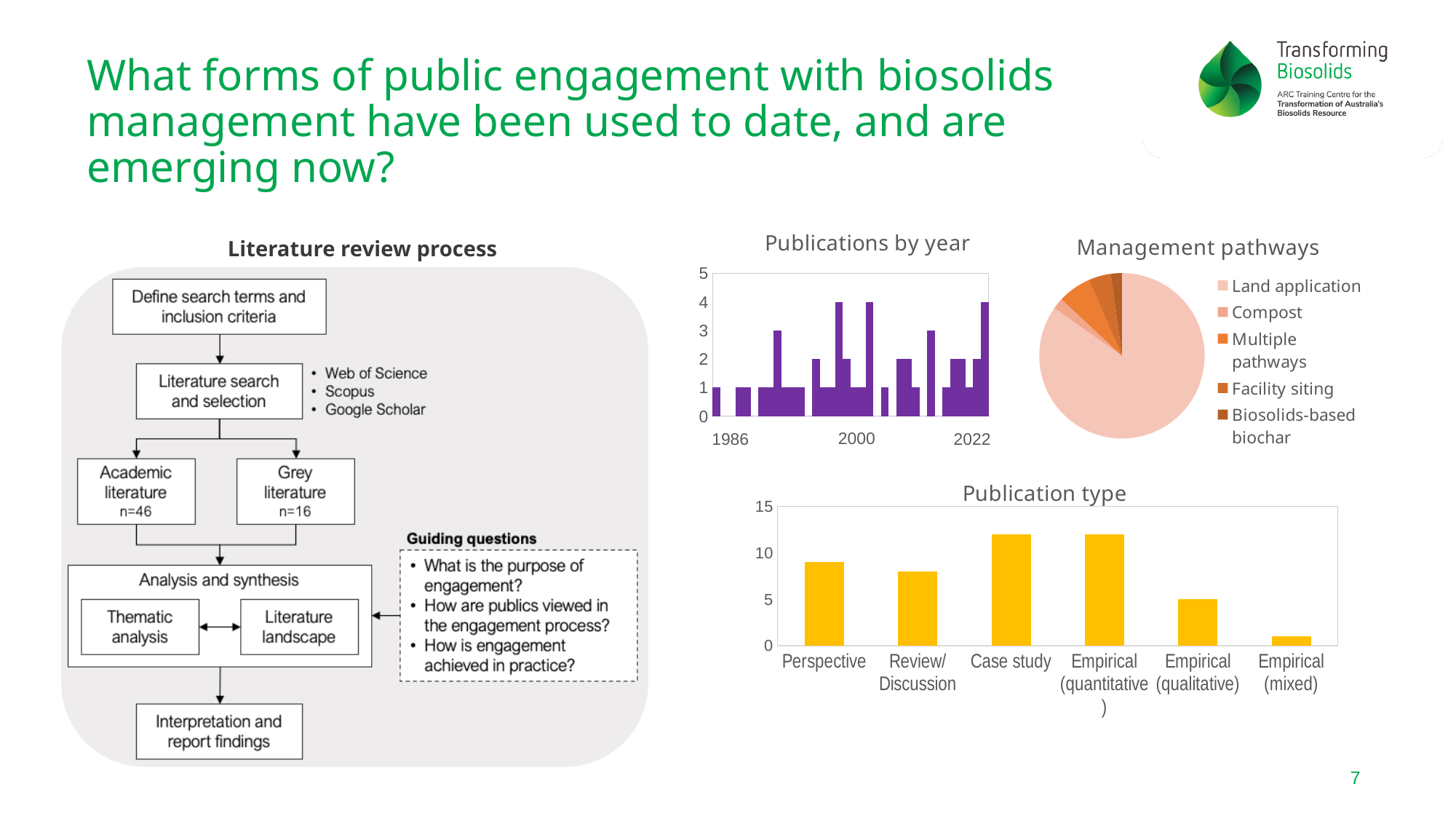
What kind of chart is the 'Management pathways' chart? pie chart What is the last year label shown on the x axis of the 'Publications by year' chart? 2022 How many entries does the legend of the 'Management pathways' chart list? 5 In the 'Publication type' chart, which is larger: Perspective or Empirical (qualitative)? Perspective What kind of chart is the 'Publication type' chart? bar chart In the 'Publication type' chart, which publication type has the lowest value? Empirical (mixed) How many categories are shown on the x axis of the 'Publication type' chart? 6 In the 'Publication type' chart, is the value for Case study greater or less than 10? greater In the 'Management pathways' pie chart, which management pathway has the largest slice? Land application In the 'Publications by year' chart, what is the highest number of publications reached in any single year? 4 What is the first year label shown on the x axis of the 'Publications by year' chart? 1986 In the 'Publication type' chart, is the value for Review/Discussion greater or less than 10? less